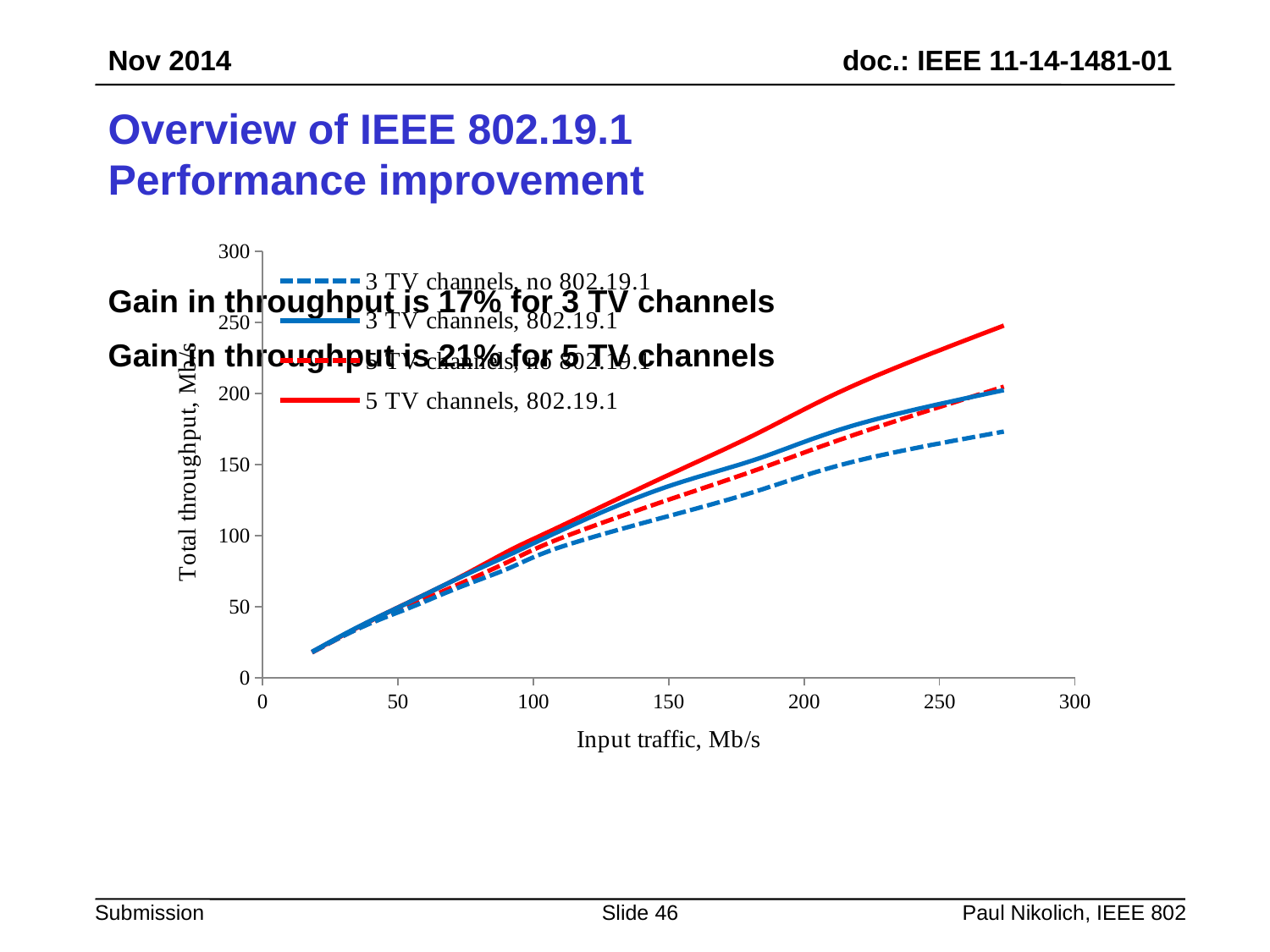
At the highest input traffic plotted, is the total throughput for '5 TV channels, 802.19.1' greater or less than 200? greater At the highest input traffic plotted, which has the larger total throughput: '5 TV channels, 802.19.1' or '3 TV channels, no 802.19.1'? 5 TV channels, 802.19.1 How many series does the chart legend list? 4 Which series has the lowest total throughput at the right end of the chart? 3 TV channels, no 802.19.1 Which series reaches the highest total throughput at the right end of the chart? 5 TV channels, 802.19.1 At an input traffic of 200 Mb/s, is the total throughput for '5 TV channels, 802.19.1' greater or less than 150? greater Does total throughput rise or fall as input traffic increases along the x axis? rise What is the title of the y axis of the chart? Total throughput, Mb/s At the highest input traffic plotted, is the total throughput for '3 TV channels, no 802.19.1' greater or less than 200? less What kind of chart is shown on the slide? line chart What is the title of the x axis of the chart? Input traffic, Mb/s